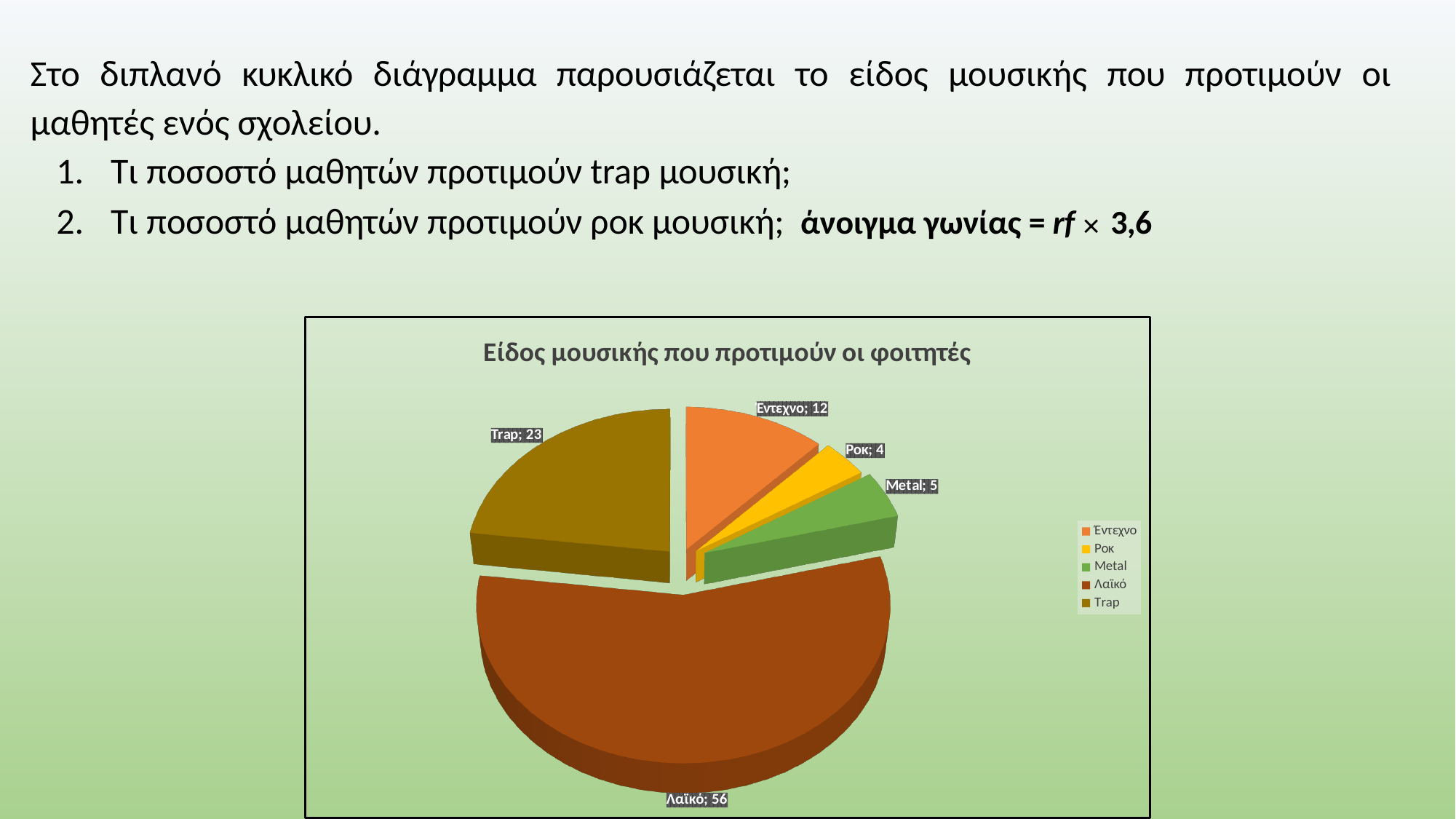
Which is larger, the value for Έντεχνο or the value for Metal? Έντεχνο What value is shown for Ροκ in the pie chart? 4 What is the difference between the values for Λαϊκό and Trap? 33 What is the title of the chart? Είδος μουσικής που προτιμούν οι φοιτητές What value is shown for Trap in the pie chart? 23 What share of the pie does Trap represent? 23% What type of chart is shown on the slide? Pie chart What value is shown for Λαϊκό in the pie chart? 56 What value is shown for Metal in the pie chart? 5 Which category has the smallest slice in the pie chart? Ροκ How many categories are shown in the pie chart? 5 Which category has the largest slice in the pie chart? Λαϊκό